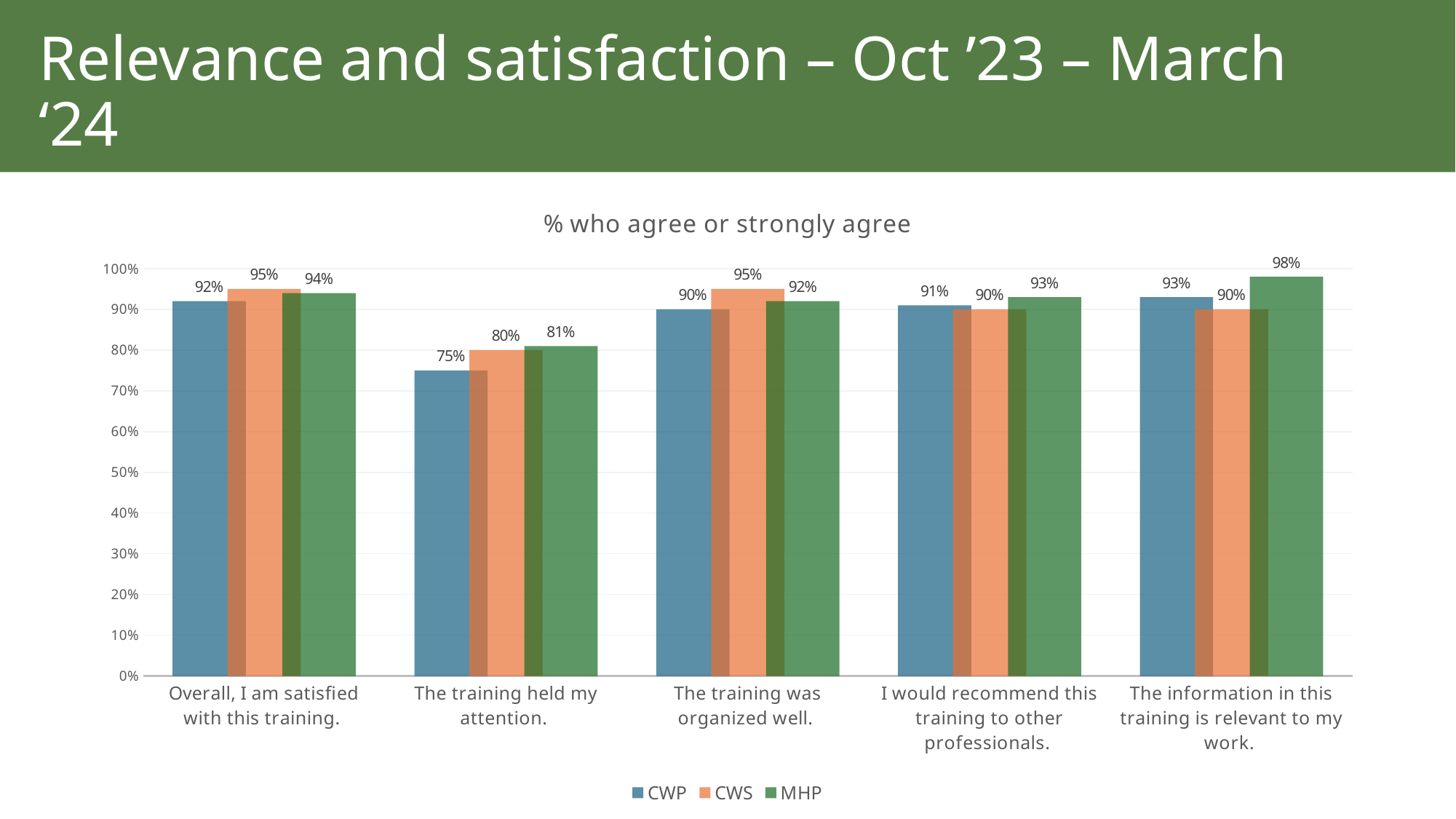
What is the CWS value for "The training was organized well."? 95% What kind of chart is shown on the slide? Bar chart For "Overall, I am satisfied with this training.", which is larger, the CWS value or the CWP value? CWS What is the difference between the MHP and CWP values for "The training held my attention."? 6% What is the CWP value for "The training held my attention."? 75% How many categories are shown on the x axis? 5 Which category has the highest MHP value? The information in this training is relevant to my work. Is the CWP value for "The training held my attention." greater or less than 80%? less What is the MHP value for "The information in this training is relevant to my work."? 98% Which category has the lowest CWP value? The training held my attention. What is the title of the chart? % who agree or strongly agree How many series does the legend list? 3